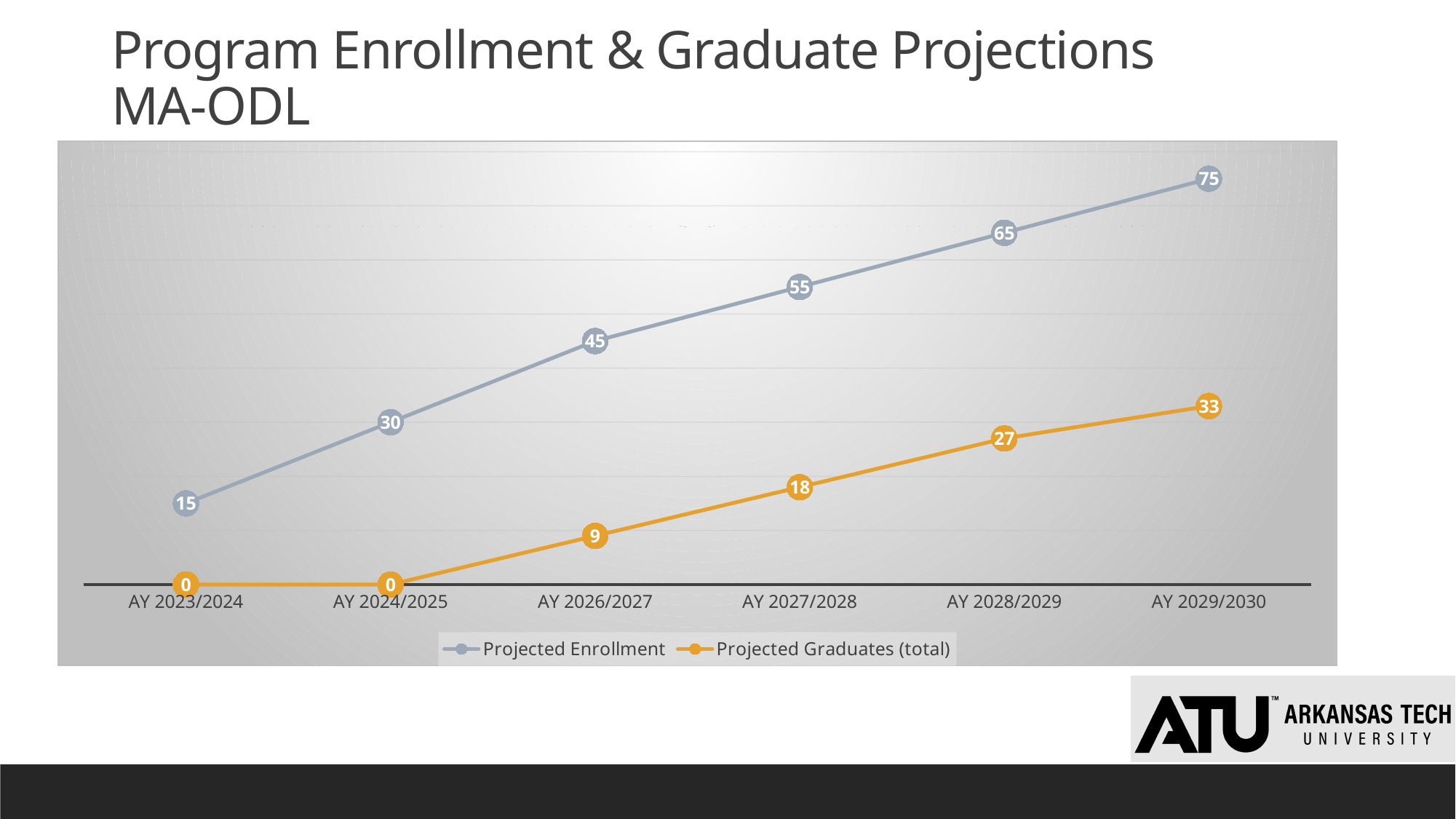
How many series does the legend list? 2 Which academic year has the highest Projected Enrollment? AY 2029/2030 What is the Projected Graduates (total) value for AY 2028/2029? 27 By how much does Projected Enrollment increase from AY 2023/2024 to AY 2024/2025? 15 Which academic year has the lowest Projected Enrollment? AY 2023/2024 Which is larger in AY 2029/2030: Projected Enrollment or Projected Graduates (total)? Projected Enrollment What is the difference between Projected Enrollment and Projected Graduates (total) in AY 2027/2028? 37 What is the Projected Enrollment for AY 2029/2030? 75 How many academic years are shown on the x axis? 6 What is the Projected Enrollment for AY 2026/2027? 45 What kind of chart is shown on the slide? Line chart Does Projected Graduates (total) rise or fall from AY 2024/2025 to AY 2029/2030? Rise